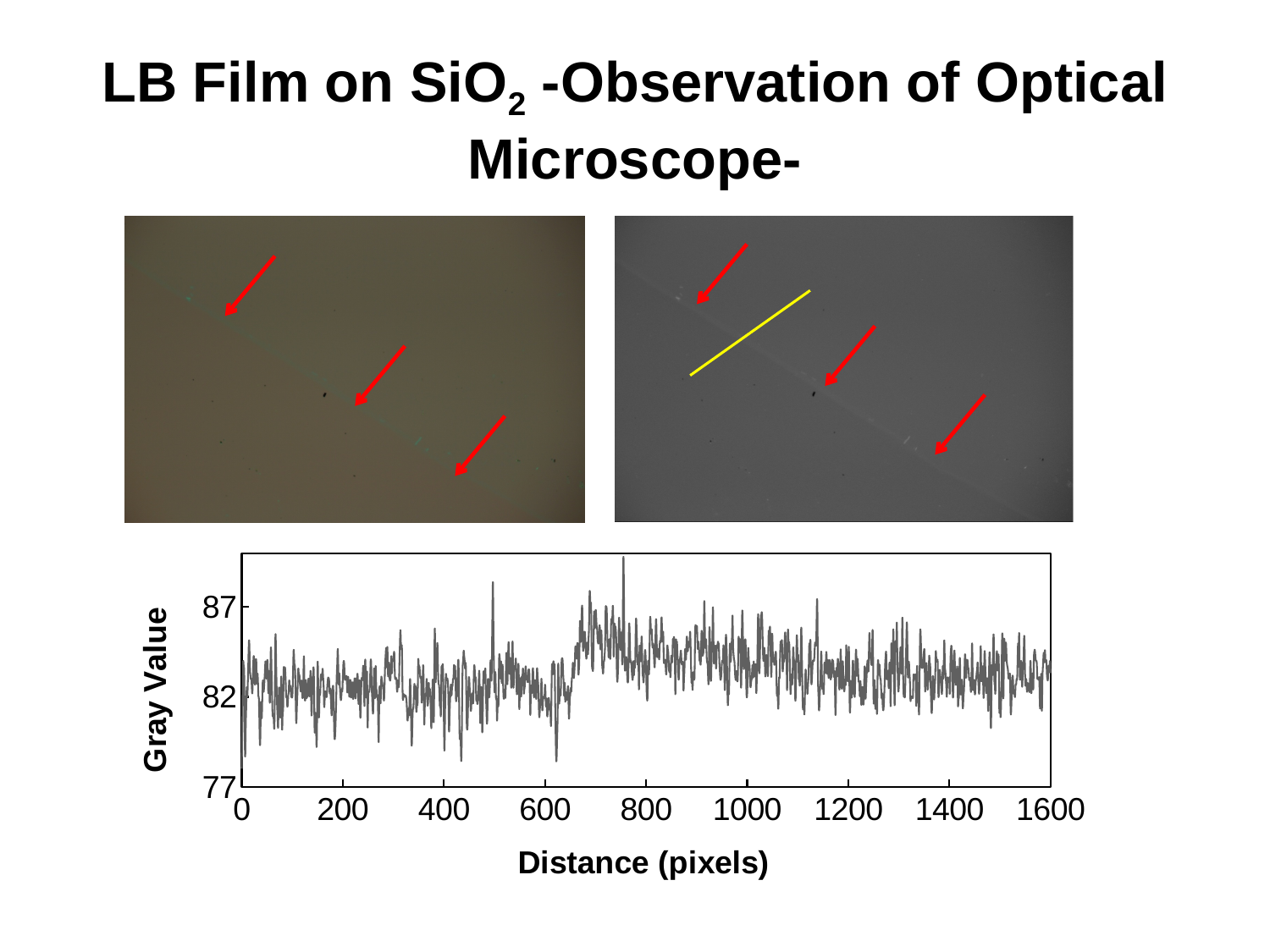
Is the lowest dip of the gray value line, near 620 pixels, greater or less than 82? less How many data series are plotted in the chart? 1 Is the highest peak of the gray value line, near 750 pixels, greater or less than 87? greater What is the label of the x axis of the chart? Distance (pixels) What kind of chart is shown on the slide? line chart Overall, does the gray value rise or fall as the distance increases from 0 to 1600 pixels? rise Is the gray value at a distance of 1000 pixels greater or less than 87? less Is the typical gray value between 800 and 1600 pixels higher or lower than the typical gray value between 0 and 600 pixels? higher What is the label of the y axis of the chart? Gray Value